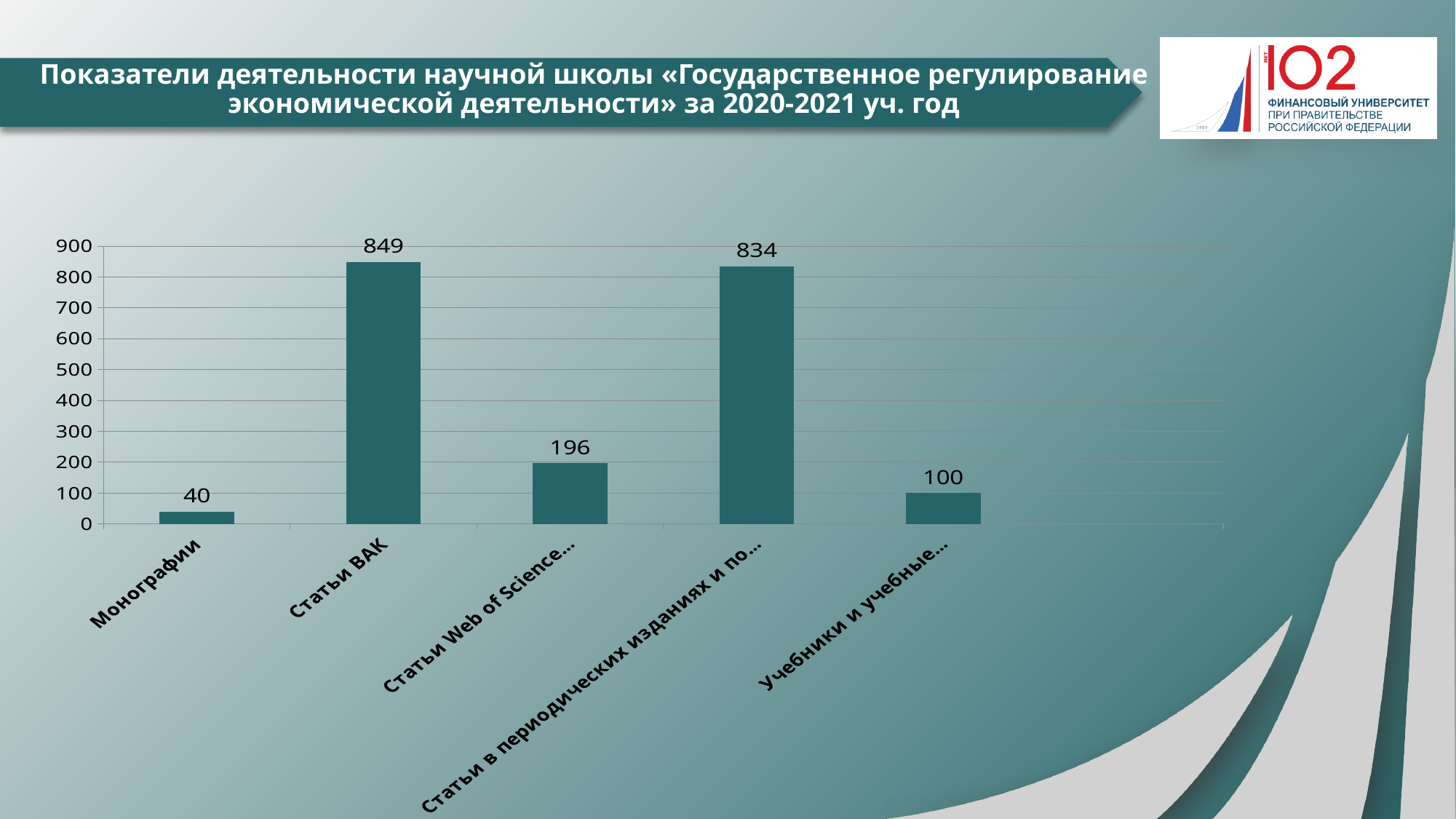
What kind of chart is shown on the slide? bar chart How many categories are shown on the x axis of the chart? 5 What is the difference between the values for Статьи ВАК and the category labelled Статьи в периодических изданиях и по…? 15 What is the value for the category labelled Статьи Web of Science…? 196 Which is larger: the value for Статьи Web of Science… or the value for Учебники и учебные…? Статьи Web of Science… Which category has the highest value? Статьи ВАК What is the value for the category labelled Учебники и учебные…? 100 Which category has the lowest value? Монографии What is the highest value shown on the vertical axis of the chart? 900 What is the value for Статьи ВАК? 849 Is the value for the category labelled Статьи в периодических изданиях и по… greater or less than 800? greater What is the value for Монографии? 40